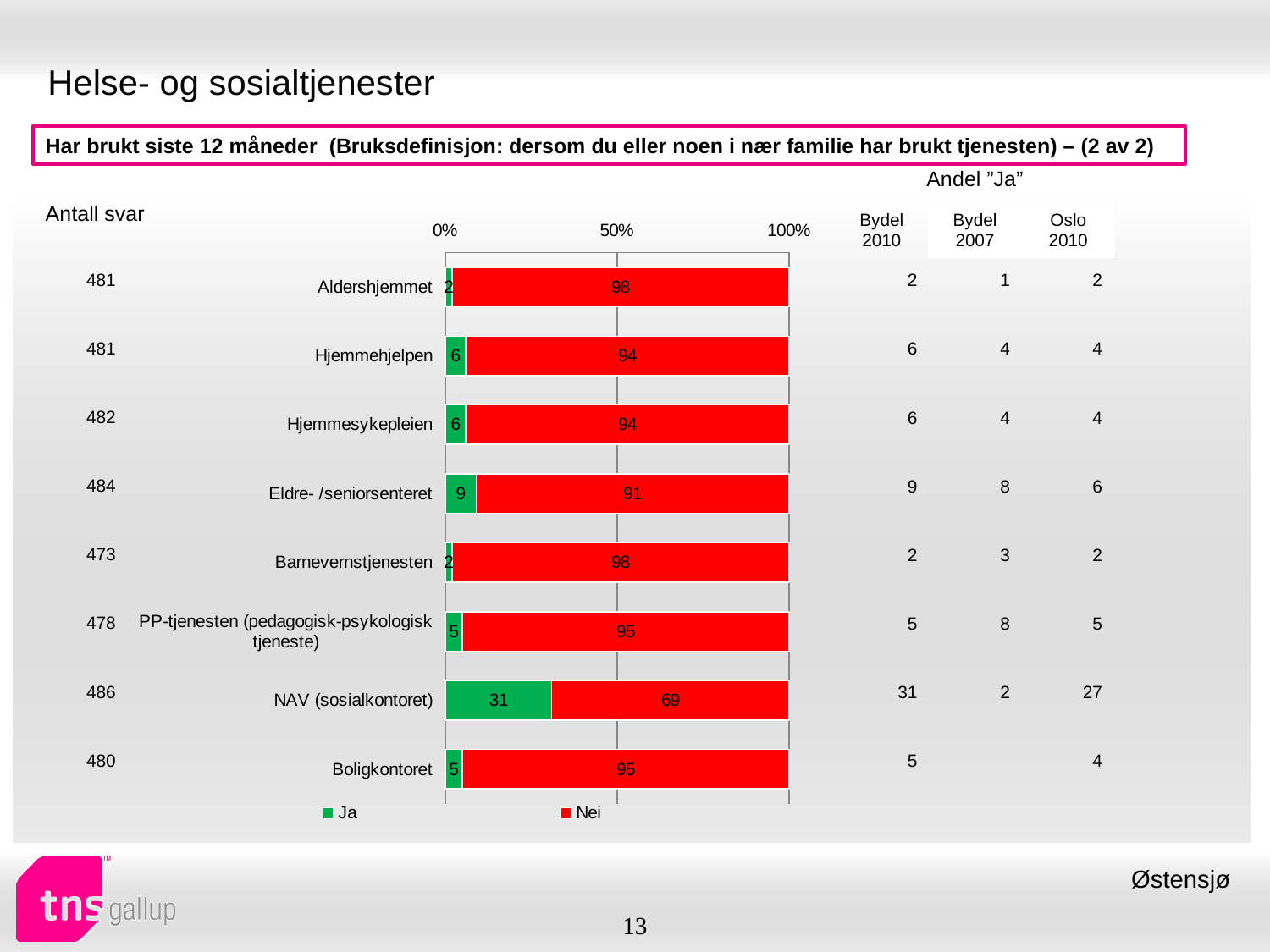
Which has a larger "Ja" value, Eldre- /seniorsenteret or Boligkontoret? Eldre- /seniorsenteret Which series is shown in red in the chart? Nei What kind of chart is shown on the slide? Stacked bar chart How many series does the chart legend list? 2 What is the "Ja" value for NAV (sosialkontoret)? 31 What is the "Nei" value for Eldre- /seniorsenteret? 91 What is the "Ja" value for Hjemmesykepleien? 6 Which category has the lowest "Nei" value? NAV (sosialkontoret) Which category has the highest "Ja" value? NAV (sosialkontoret) What is the difference between the "Nei" values for Aldershjemmet and NAV (sosialkontoret)? 29 How many categories (services) are plotted in the chart? 8 What is the total of the stacked bar for Hjemmehjelpen? 100